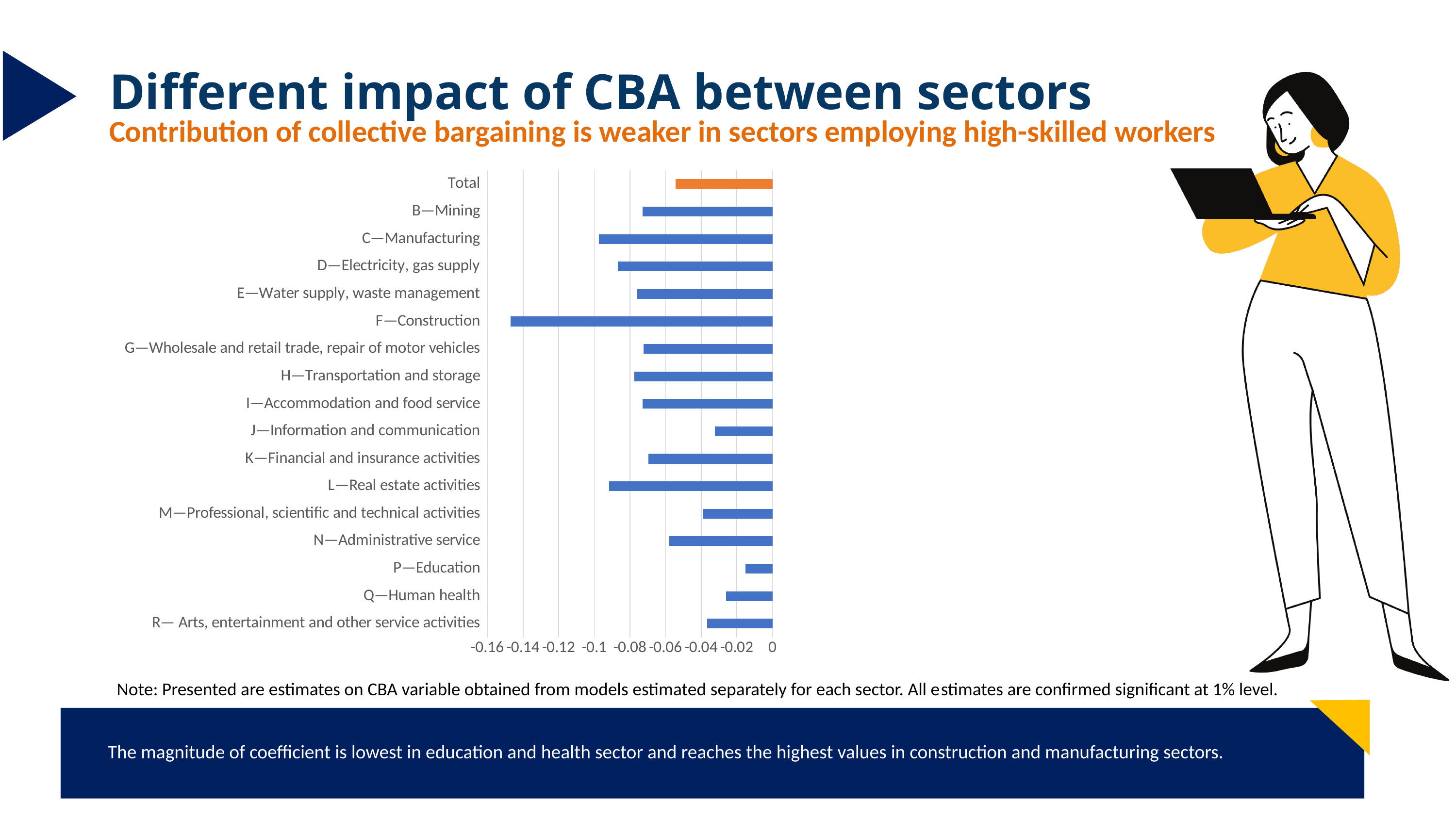
Is the value for F—Construction greater or less than -0.14? less Is the value for P—Education greater or less than -0.02? greater Is the value for L—Real estate activities greater or less than -0.1? greater Which has the larger magnitude coefficient, Q—Human health or P—Education? Q—Human health How many bars (categories) are plotted in the chart, including Total? 17 Which sector has the smallest magnitude (closest to zero) coefficient in the chart? P—Education Which has the larger magnitude coefficient, F—Construction or C—Manufacturing? F—Construction Which bar in the chart is coloured orange rather than blue? Total What kind of chart is shown on the slide? Bar chart Which sector has the most negative (largest magnitude) coefficient in the chart? F—Construction